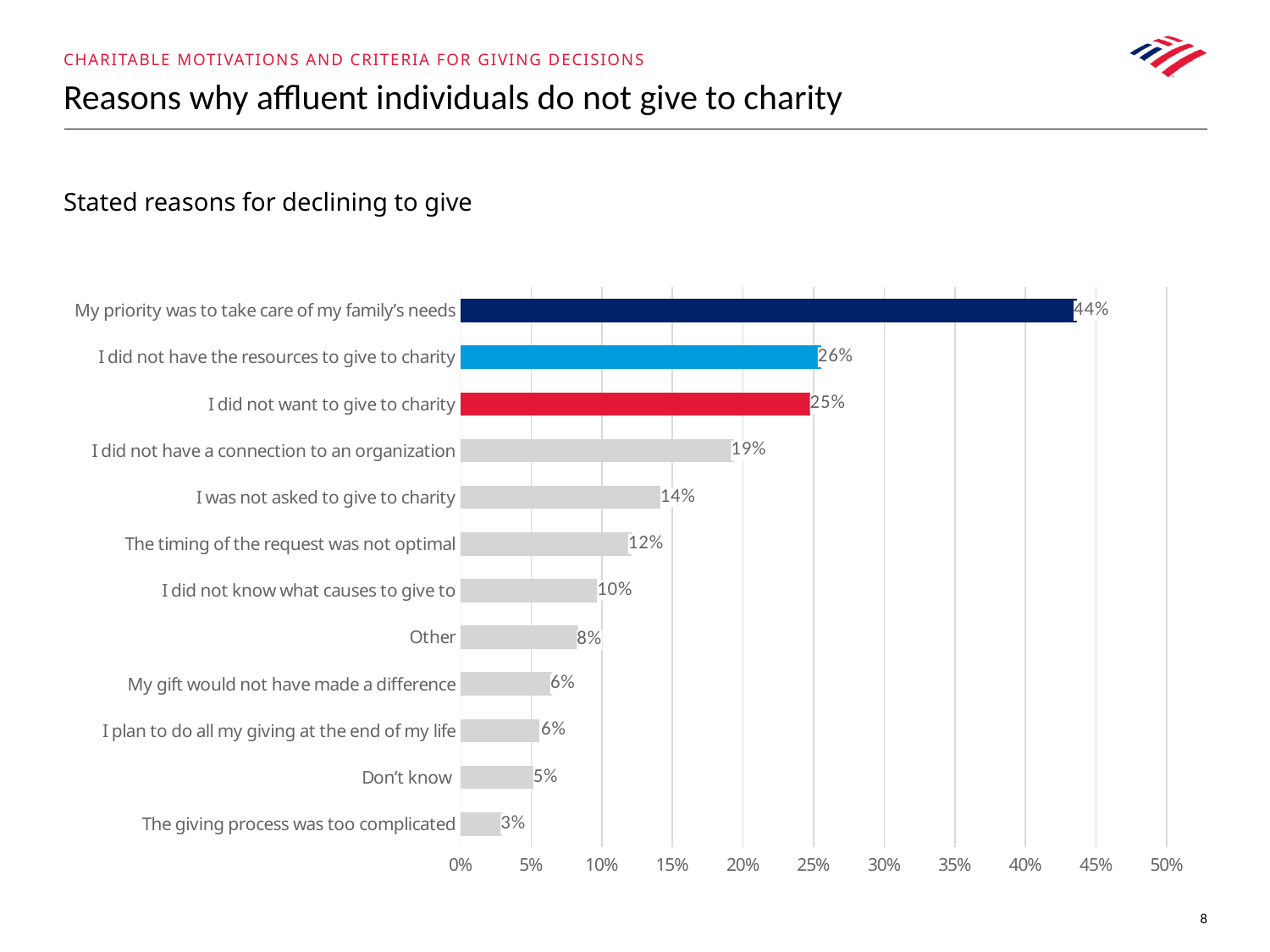
Which stated reason has the lowest value? The giving process was too complicated Is the value for "I did not want to give to charity" greater or less than 20%? greater What is the difference between "I did not have the resources to give to charity" and "I was not asked to give to charity"? 12% What is the value for "I did not have a connection to an organization"? 19% Which stated reason for declining to give has the highest value? My priority was to take care of my family's needs Which is larger: "The timing of the request was not optimal" or "I did not know what causes to give to"? The timing of the request was not optimal What is the value for "Don't know"? 5% What is the subtitle of the chart? Stated reasons for declining to give How many stated reasons are shown in the chart? 12 What kind of chart is used to show the stated reasons for declining to give? Bar chart What percentage of respondents said their priority was to take care of their family's needs? 44% What percentage said the giving process was too complicated? 3%